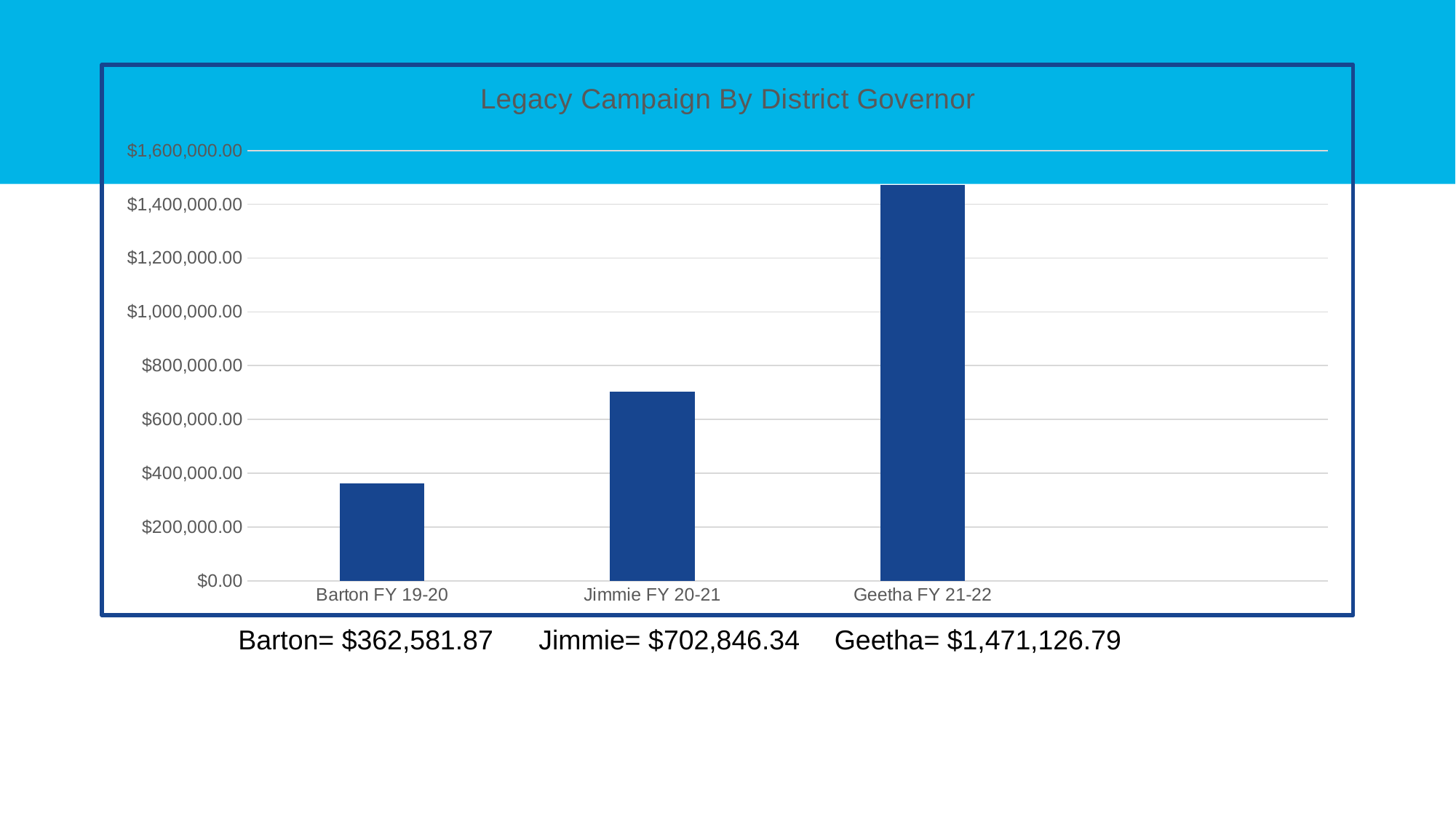
Do the values rise or fall from Barton FY 19-20 to Geetha FY 21-22 along the x axis? Rise How many district governors (categories) are plotted in the chart? 3 What is the title of the chart? Legacy Campaign By District Governor How much larger is Jimmie's value than Barton's? $340,264.47 Which district governor has the highest Legacy Campaign value? Geetha FY 21-22 Which district governor has the lowest Legacy Campaign value? Barton FY 19-20 What is the Legacy Campaign value for Barton FY 19-20? $362,581.87 What is the difference between Geetha's value and Jimmie's value? $768,280.45 Is the value for Geetha FY 21-22 greater or less than $1,400,000.00? greater What is the Legacy Campaign value for Geetha FY 21-22? $1,471,126.79 What kind of chart is shown on the slide? Bar chart What is the Legacy Campaign value for Jimmie FY 20-21? $702,846.34